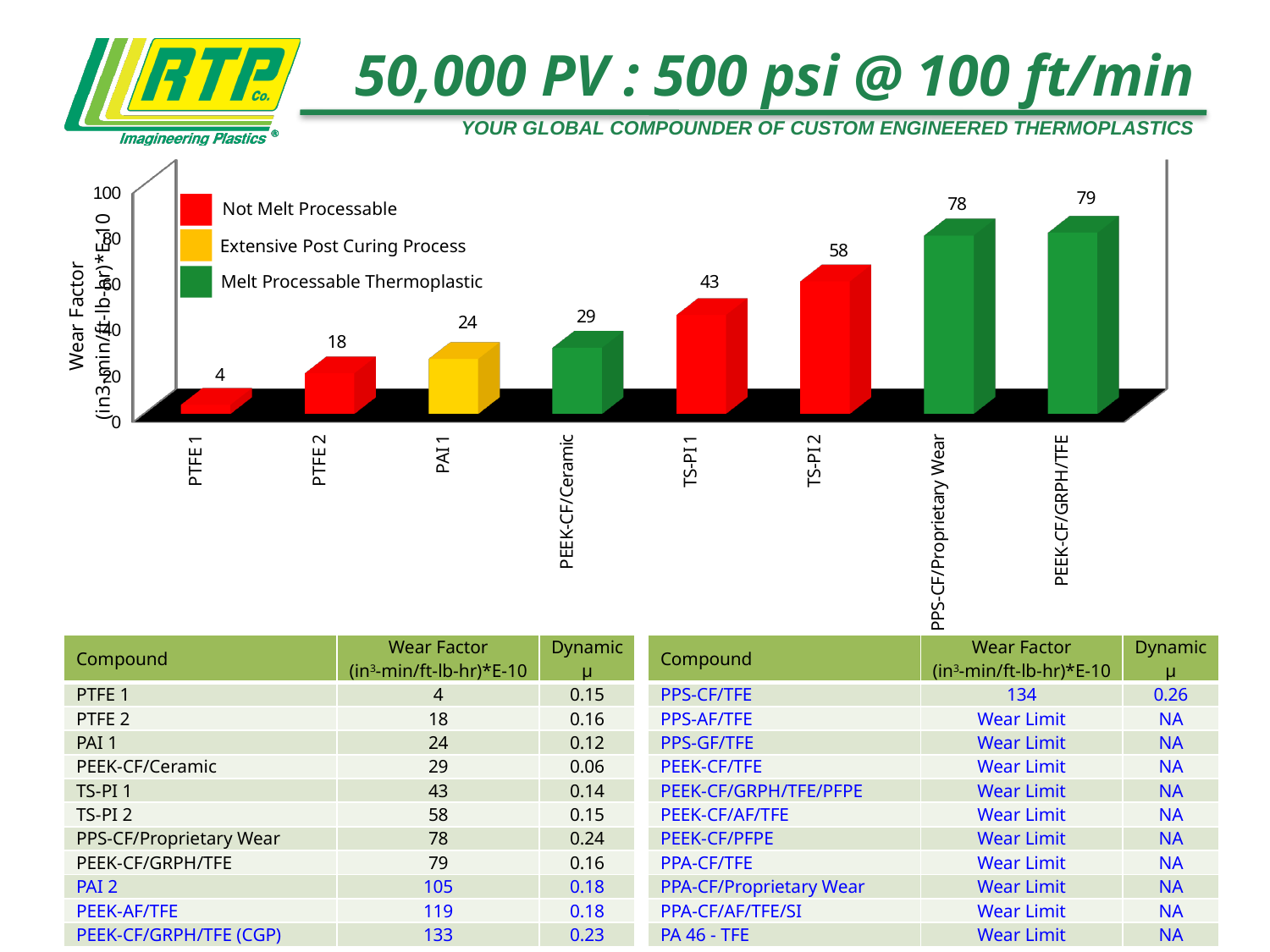
Which has a higher wear factor, PAI 1 or PEEK-CF/Ceramic? PEEK-CF/Ceramic What is the wear factor value shown for PPS-CF/Proprietary Wear in the chart? 78 Which compound has the lowest wear factor in the chart? PTFE 1 Do the wear factor values rise or fall from left to right across the chart? Rise How many compounds are plotted as bars in the chart? 8 What type of chart is shown on the slide? Bar chart What is the wear factor value shown for PEEK-CF/Ceramic in the chart? 29 What is the wear factor value shown for TS-PI 2 in the chart? 58 Which compound has the highest wear factor in the chart? PEEK-CF/GRPH/TFE How many entries does the chart legend list? 3 What is the wear factor value shown for PTFE 1 in the chart? 4 What is the difference between the wear factor of TS-PI 2 and TS-PI 1? 15